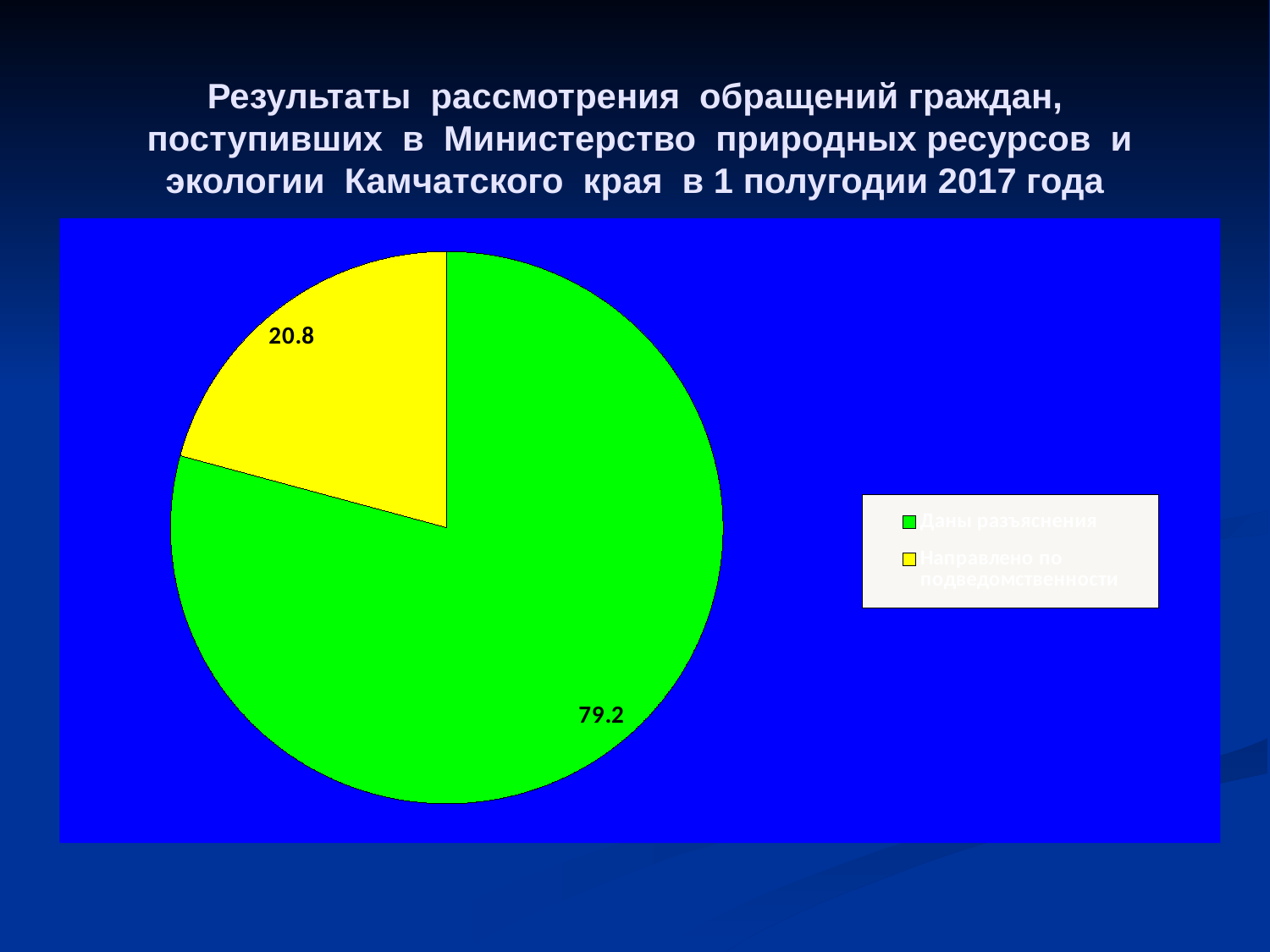
Which slice of the pie chart is the smallest? Направлено по подведомственности What is the difference between the values of the green slice and the yellow slice? 58.4 How many slices does the pie chart have? 2 Which is larger: the green slice or the yellow slice? The green slice What kind of chart is shown on the slide? Pie chart What colour is the slice labelled "Направлено по подведомственности"? Yellow What is the value for "Даны разъяснения" in the pie chart? 79.2 What value is shown on the yellow slice of the pie chart? 20.8 What is the value for "Направлено по подведомственности" in the pie chart? 20.8 How many entries does the legend of the pie chart list? 2 What value is shown on the green slice of the pie chart? 79.2 Which slice of the pie chart is the largest? Даны разъяснения